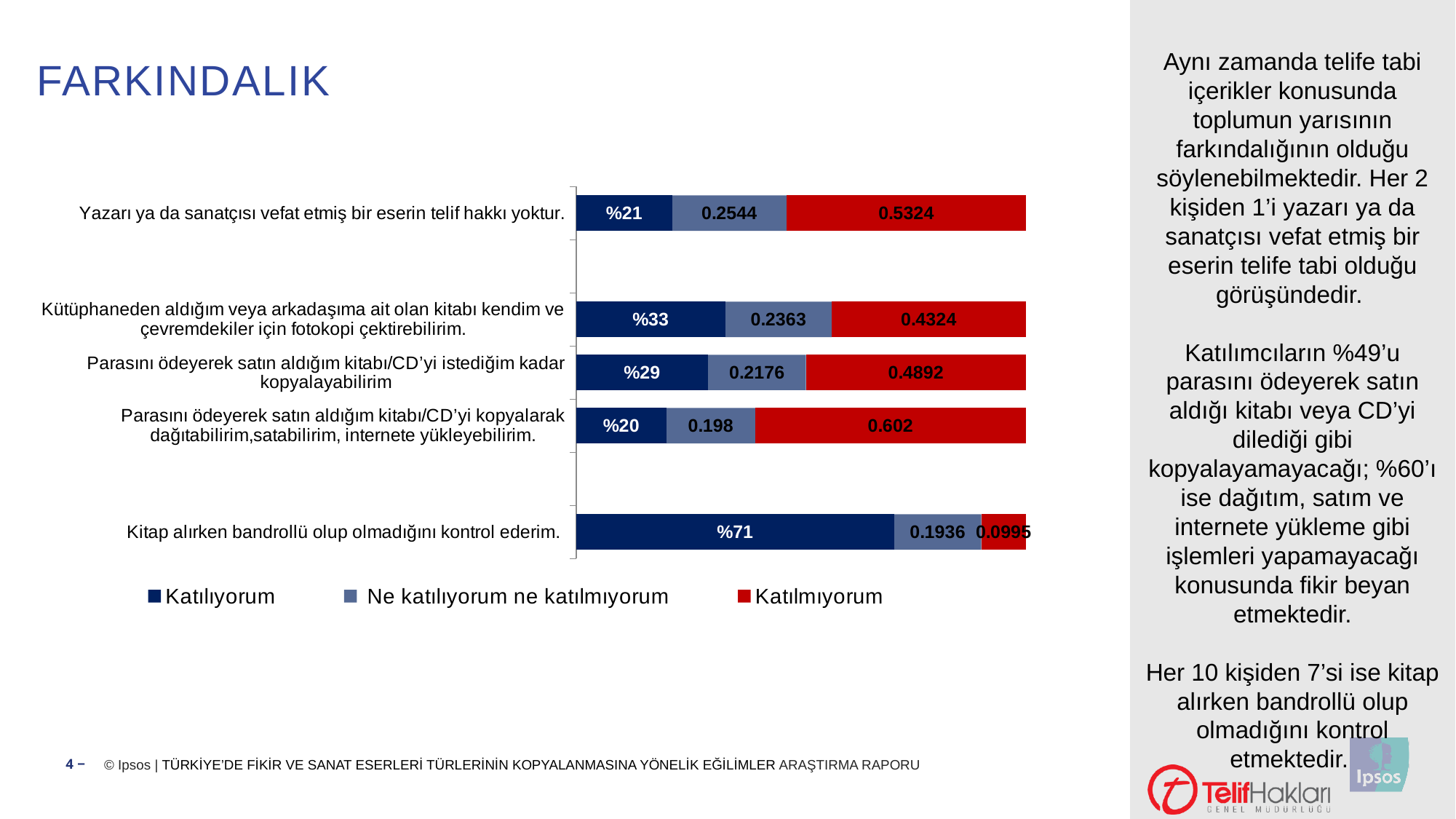
What is the Katılmıyorum value for "Yazarı ya da sanatçısı vefat etmiş bir eserin telif hakkı yoktur."? 0.5324 Which statement has the highest Katılıyorum value? Kitap alırken bandrollü olup olmadığını kontrol ederim. What is the difference between the Katılmıyorum values for "Parasını ödeyerek satın aldığım kitabı/CD'yi kopyalarak dağıtabilirim,satabilirim, internete yükleyebilirim." and "Kitap alırken bandrollü olup olmadığını kontrol ederim."? 0.5025 What is the Katılıyorum value for "Kitap alırken bandrollü olup olmadığını kontrol ederim."? %71 Which statement has the lowest Katılmıyorum value? Kitap alırken bandrollü olup olmadığını kontrol ederim. Which series is shown in red in the chart? Katılmıyorum What kind of chart is shown on the slide? Stacked bar chart Which statement has the highest Katılmıyorum value? Parasını ödeyerek satın aldığım kitabı/CD'yi kopyalarak dağıtabilirim,satabilirim, internete yükleyebilirim. How many series does the legend list? 3 How many statements (categories) are shown in the chart? 5 Which is larger: the Katılıyorum value for "Kütüphaneden aldığım veya arkadaşıma ait olan kitabı kendim ve çevremdekiler için fotokopi çektirebilirim." or for "Yazarı ya da sanatçısı vefat etmiş bir eserin telif hakkı yoktur."? Kütüphaneden aldığım veya arkadaşıma ait olan kitabı kendim ve çevremdekiler için fotokopi çektirebilirim. What is the Ne katılıyorum ne katılmıyorum value for "Parasını ödeyerek satın aldığım kitabı/CD'yi istediğim kadar kopyalayabilirim"? 0.2176